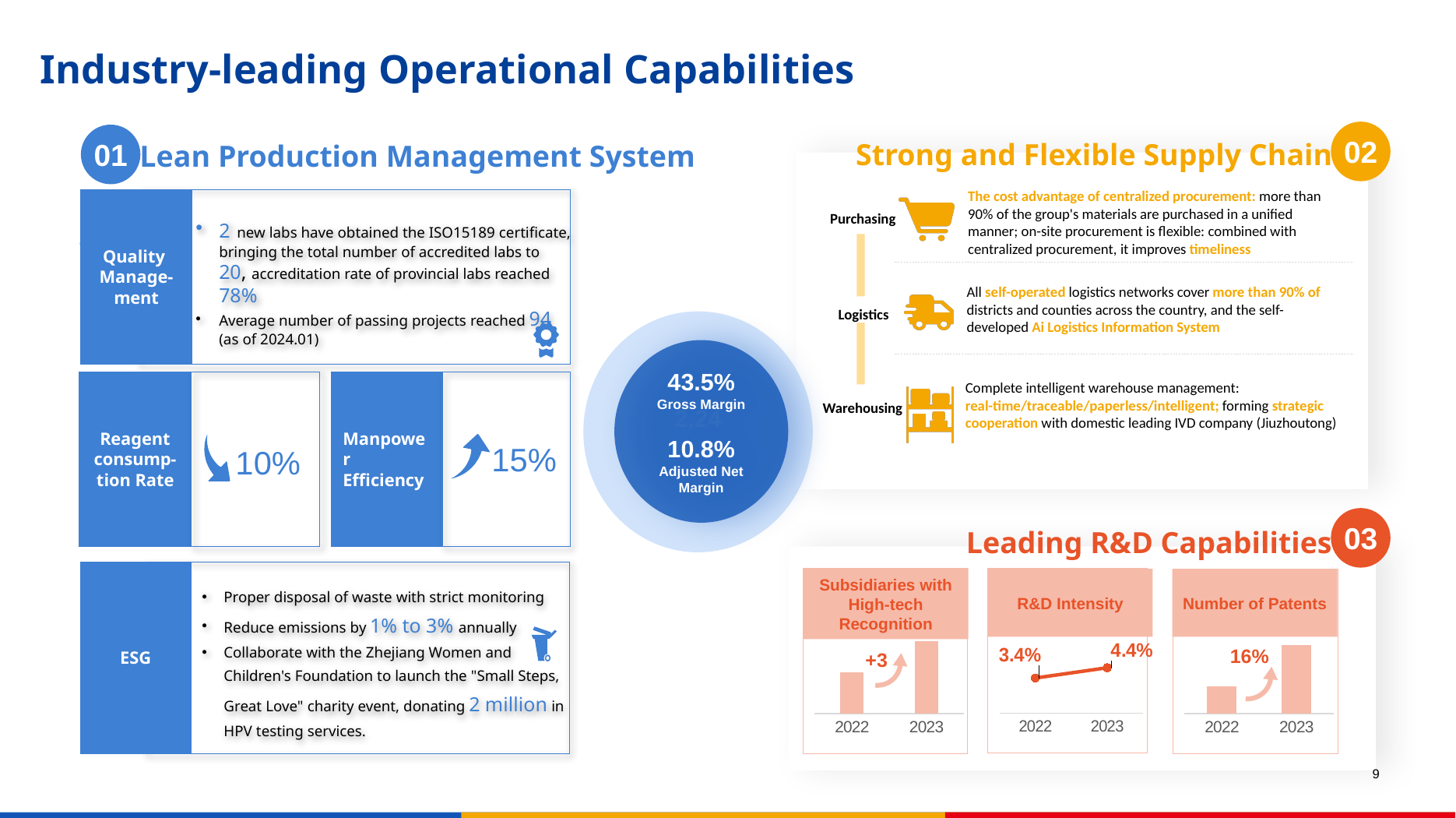
In the R&D Intensity chart, what is the value for 2023? 4.4% What kind of chart is the R&D Intensity chart? line chart In the Number of Patents chart, what growth figure is printed between the 2022 and 2023 bars? 16% In the R&D Intensity chart, by how much did the value change from 2022 to 2023? 1.0% In the Number of Patents chart, which year has the taller bar? 2023 In the Subsidiaries with High-tech Recognition chart, what change is printed between the 2022 and 2023 bars? +3 How many years are shown on the x axis of the Subsidiaries with High-tech Recognition chart? 2 In the R&D Intensity chart, which year has the higher value? 2023 In the Subsidiaries with High-tech Recognition chart, which year has the lower bar? 2022 In the R&D Intensity chart, what is the value for 2022? 3.4% In the R&D Intensity chart, do values rise or fall from 2022 to 2023? rise What kind of chart is the Number of Patents chart? bar chart